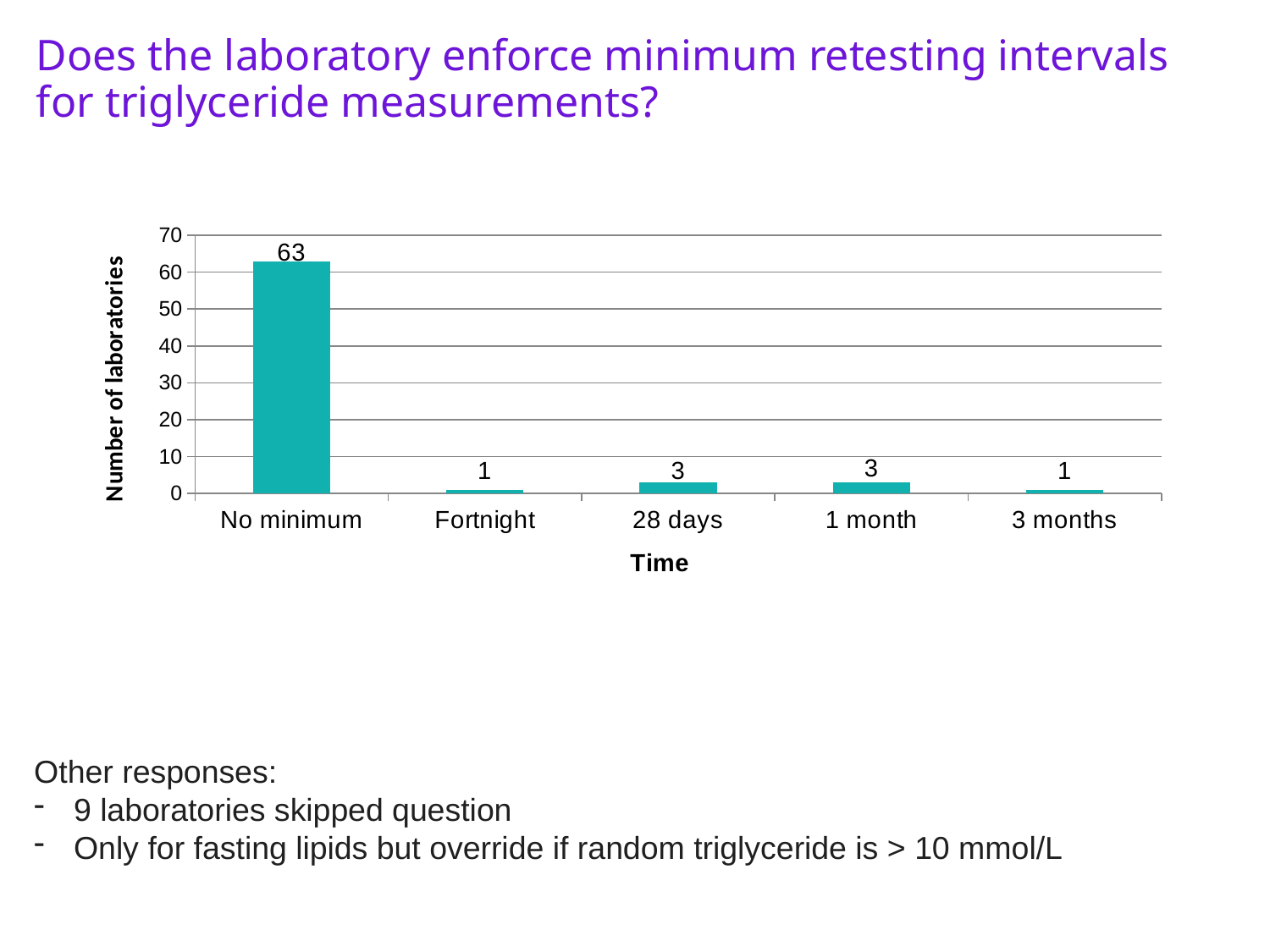
Is the value for 'No minimum' greater or less than 50? greater Which has more laboratories, '28 days' or '3 months'? 28 days Which category has the highest number of laboratories? No minimum What kind of chart is shown on the slide? bar chart What is the total number of laboratories across all five categories in the chart? 71 What is the number of laboratories for the '28 days' category? 3 What is the label of the x axis? Time What is the number of laboratories for the 'No minimum' category? 63 How many categories are shown on the x axis? 5 What is the number of laboratories for the 'Fortnight' category? 1 What is the label of the y axis? Number of laboratories What is the difference in number of laboratories between 'No minimum' and '1 month'? 60